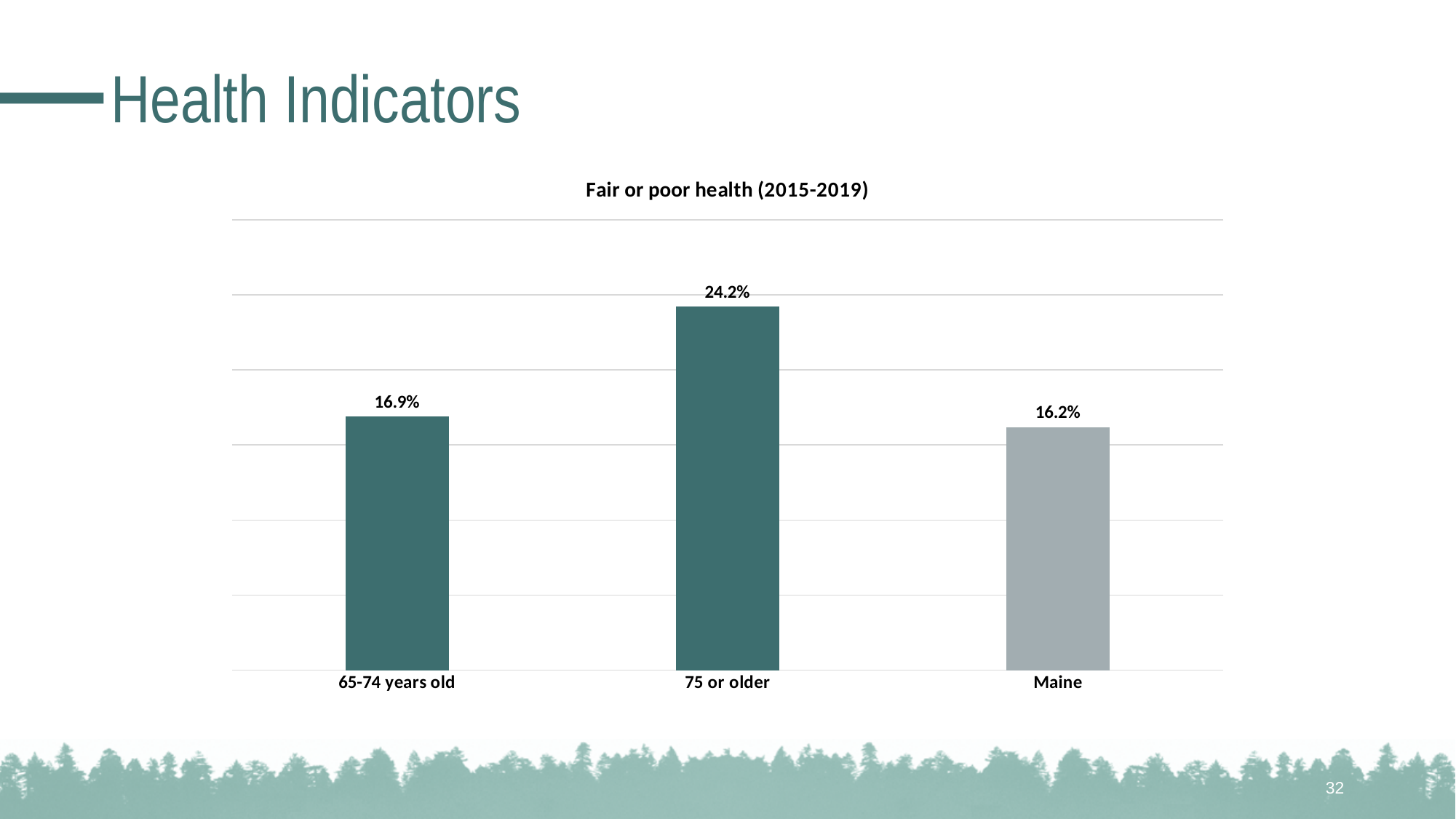
How many categories are shown in the Fair or poor health (2015-2019) chart? 3 What is the difference between the values for 75 or older and 65-74 years old in the Fair or poor health (2015-2019) chart? 7.3% Which category has the lowest value in the Fair or poor health (2015-2019) chart? Maine What is the value for Maine in the Fair or poor health (2015-2019) chart? 16.2% What kind of chart is the Fair or poor health (2015-2019) chart? Bar chart Which is larger in the Fair or poor health (2015-2019) chart: the value for 75 or older or the value for Maine? 75 or older Which bar in the Fair or poor health (2015-2019) chart is coloured grey rather than dark teal? Maine Which category has the highest value in the Fair or poor health (2015-2019) chart? 75 or older What is the difference between the values for 65-74 years old and Maine in the Fair or poor health (2015-2019) chart? 0.7% What is the value for 75 or older in the Fair or poor health (2015-2019) chart? 24.2% What is the title of the chart on the slide? Fair or poor health (2015-2019) What is the value for 65-74 years old in the Fair or poor health (2015-2019) chart? 16.9%